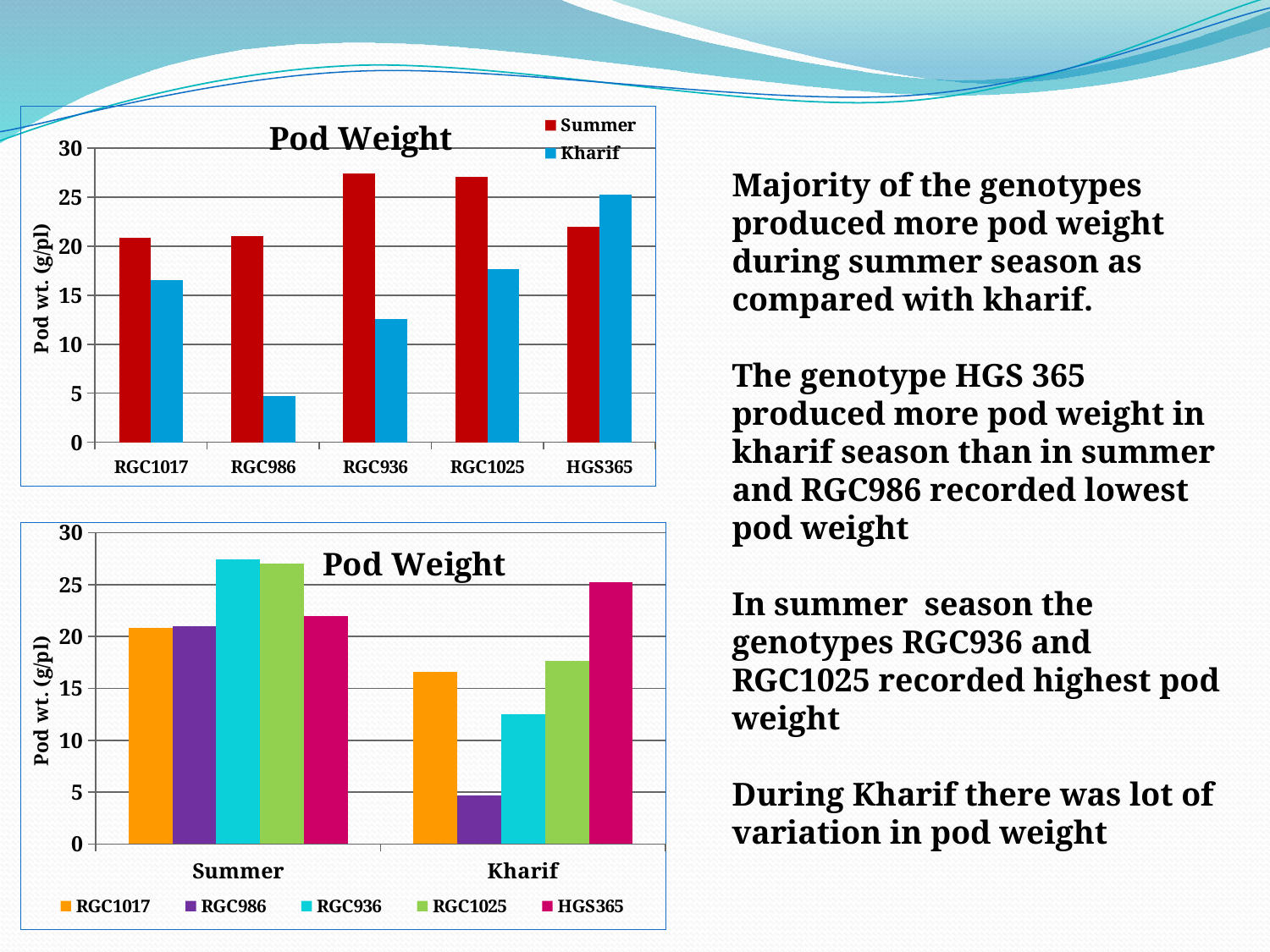
On the top chart, is the Summer value for RGC936 greater or less than 25? greater On the top chart, how many genotypes are shown on the x axis? 5 On the top chart, how many series does the legend list? 2 On the top chart, is the Kharif value for RGC986 greater or less than 5? less On the top chart, which genotype has the highest Kharif pod weight? HGS365 On the bottom chart, how many series does the legend list? 5 On the top chart, for HGS365, which season has the larger pod weight, Summer or Kharif? Kharif On the bottom chart, how many categories are shown on the x axis? 2 On the top chart, what colour are the Summer bars? red On the top chart, which genotype has the lowest Kharif pod weight? RGC986 On the bottom chart, is the Kharif value for RGC1017 greater or less than 15? greater On the top chart, what kind of chart is it? bar chart